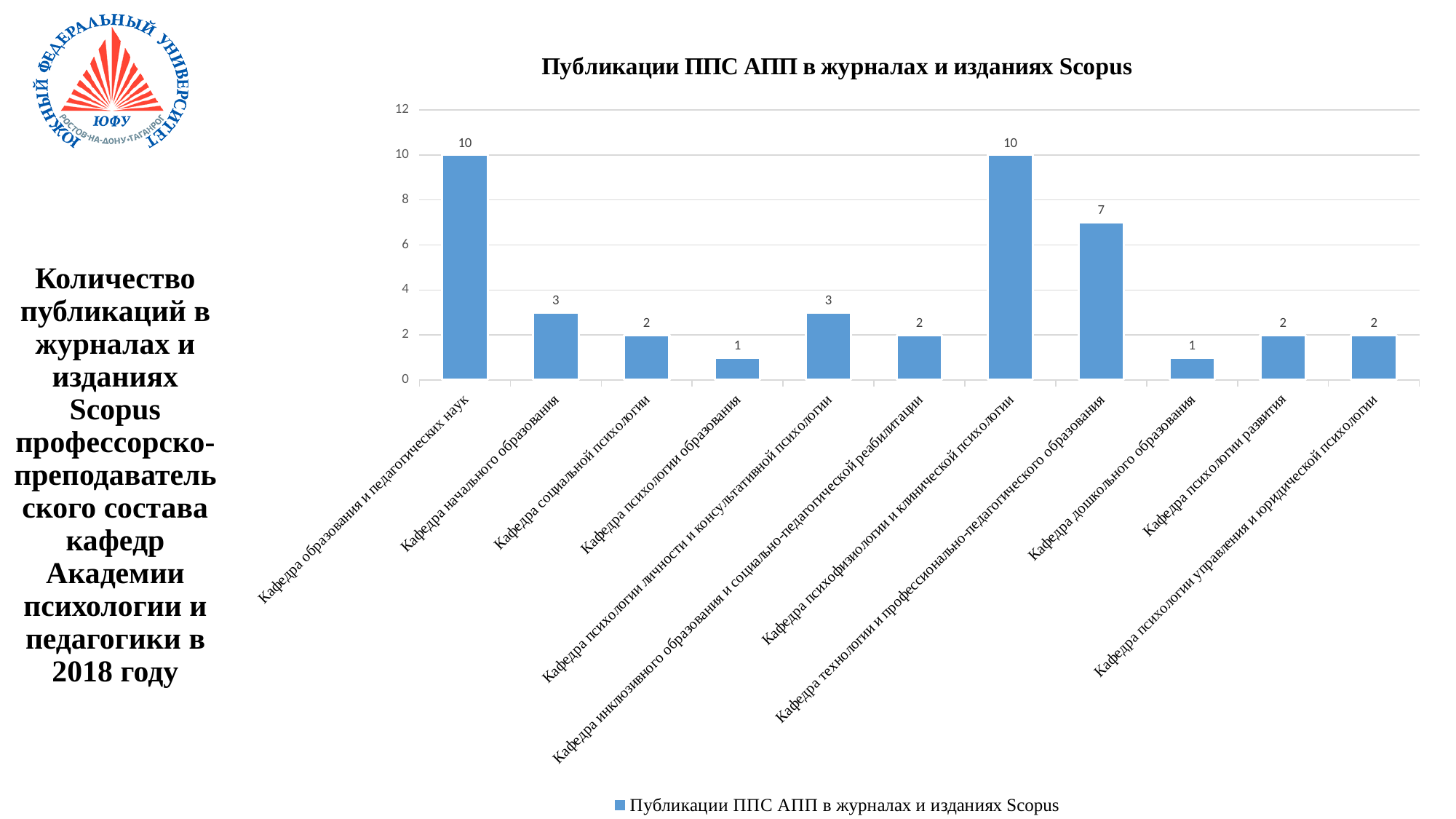
How many categories (departments) are shown on the x axis? 11 Is the value for Кафедра технологии и профессионально-педагогического образования greater or less than 6? greater What is the title of the chart? Публикации ППС АПП в журналах и изданиях Scopus What is the value for Кафедра начального образования? 3 What is the value for Кафедра психофизиологии и клинической психологии? 10 What is the value for Кафедра дошкольного образования? 1 What is the value for Кафедра психологии управления и юридической психологии? 2 What is the difference between the values for Кафедра образования и педагогических наук and Кафедра технологии и профессионально-педагогического образования? 3 How many series does the legend list? 1 What kind of chart is shown on the slide? bar chart What is the value for Кафедра технологии и профессионально-педагогического образования? 7 Which is larger: the value for Кафедра начального образования or the value for Кафедра социальной психологии? Кафедра начального образования